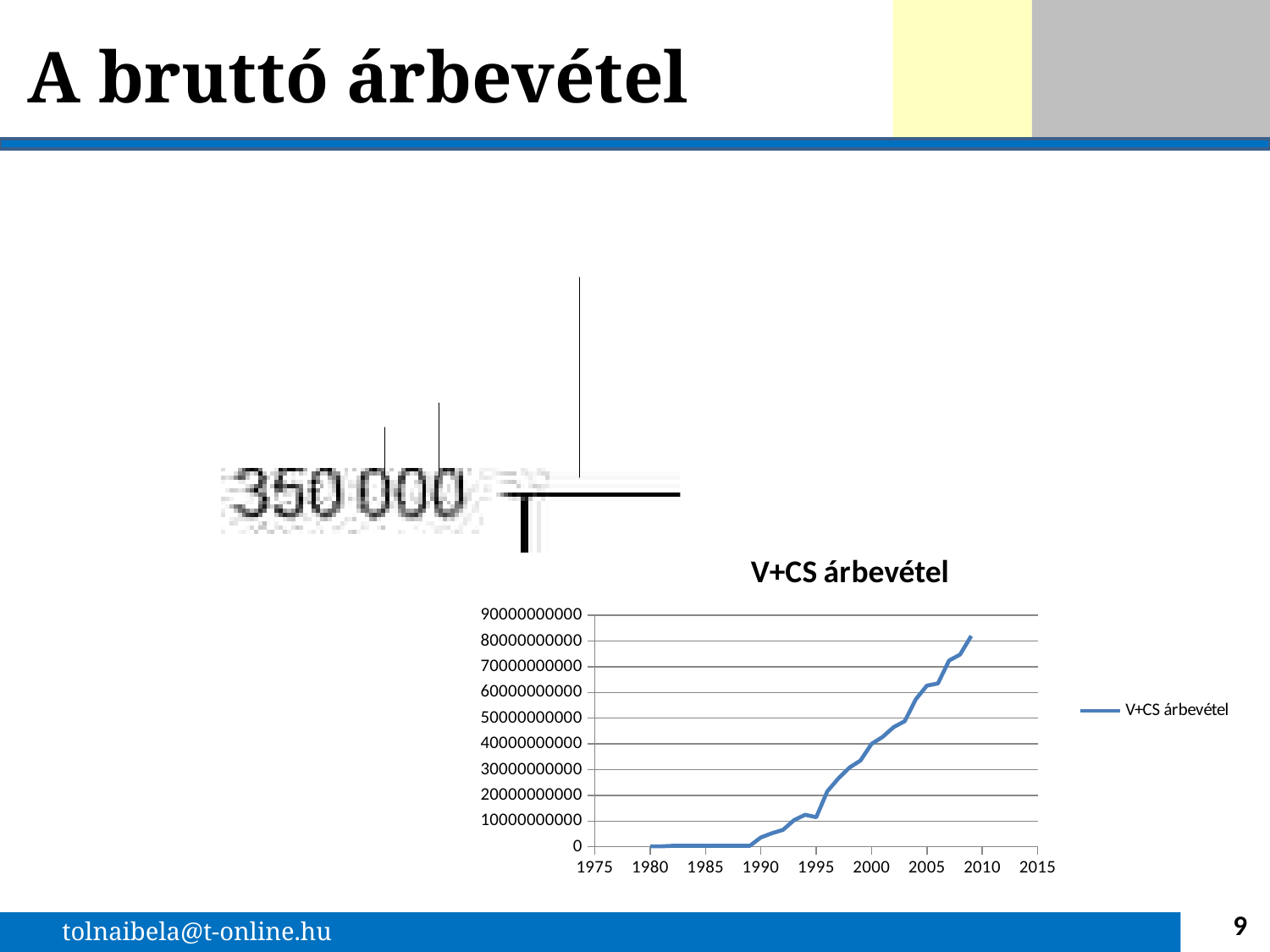
Is the value for 2000 greater or less than 30000000000? greater What is the name of the series shown in the legend? V+CS árbevétel Is the value for 1990 greater or less than 10000000000? less Which year has the larger value, 2000 or 2005? 2005 What is the title of the chart? V+CS árbevétel Is the value for 1995 greater or less than 20000000000? less Does the V+CS árbevétel line generally rise or fall from 1980 to 2010? rise What kind of chart is shown on the slide? line chart How many series does the chart's legend list? 1 Which year has the larger value, 1995 or 2000? 2000 How many year labels are shown on the x axis? 9